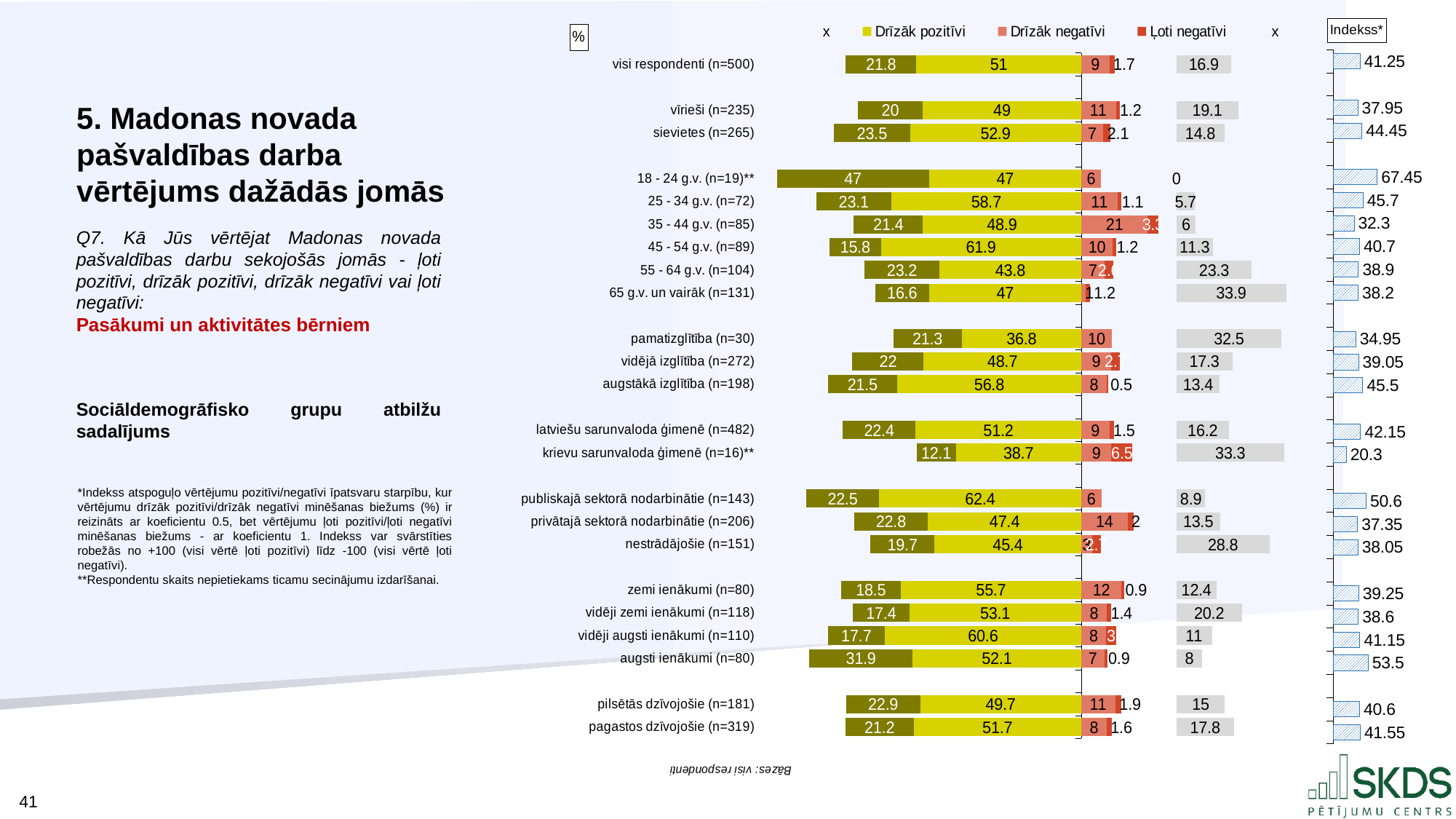
Which respondent group has the lowest Indekss value? krievu sarunvaloda ģimenē (n=16)** What is the difference between the 'Drīzāk pozitīvi' values for '45 - 54 g.v. (n=89)' and '55 - 64 g.v. (n=104)'? 18.1 What is the Indekss value for 'augsti ienākumi (n=80)'? 53.5 Which has a larger 'Drīzāk pozitīvi' value: 'publiskajā sektorā nodarbinātie (n=143)' or 'privātajā sektorā nodarbinātie (n=206)'? publiskajā sektorā nodarbinātie (n=143) How many series are named in the legend at the top of the chart? 3 Which topic is being evaluated in this chart, as shown in red text on the slide? Pasākumi un aktivitātes bērniem What is the difference between the Indekss values for 'sievietes (n=265)' and 'vīrieši (n=235)'? 6.5 What is the 'Drīzāk pozitīvi' value for 'visi respondenti (n=500)'? 51 What type of chart is used to show the response distribution by respondent group? Stacked bar chart How many respondent groups are listed in the chart? 23 What is the 'Drīzāk negatīvi' value for '35 - 44 g.v. (n=85)'? 21 Which respondent group has the highest Indekss value? 18 - 24 g.v. (n=19)**